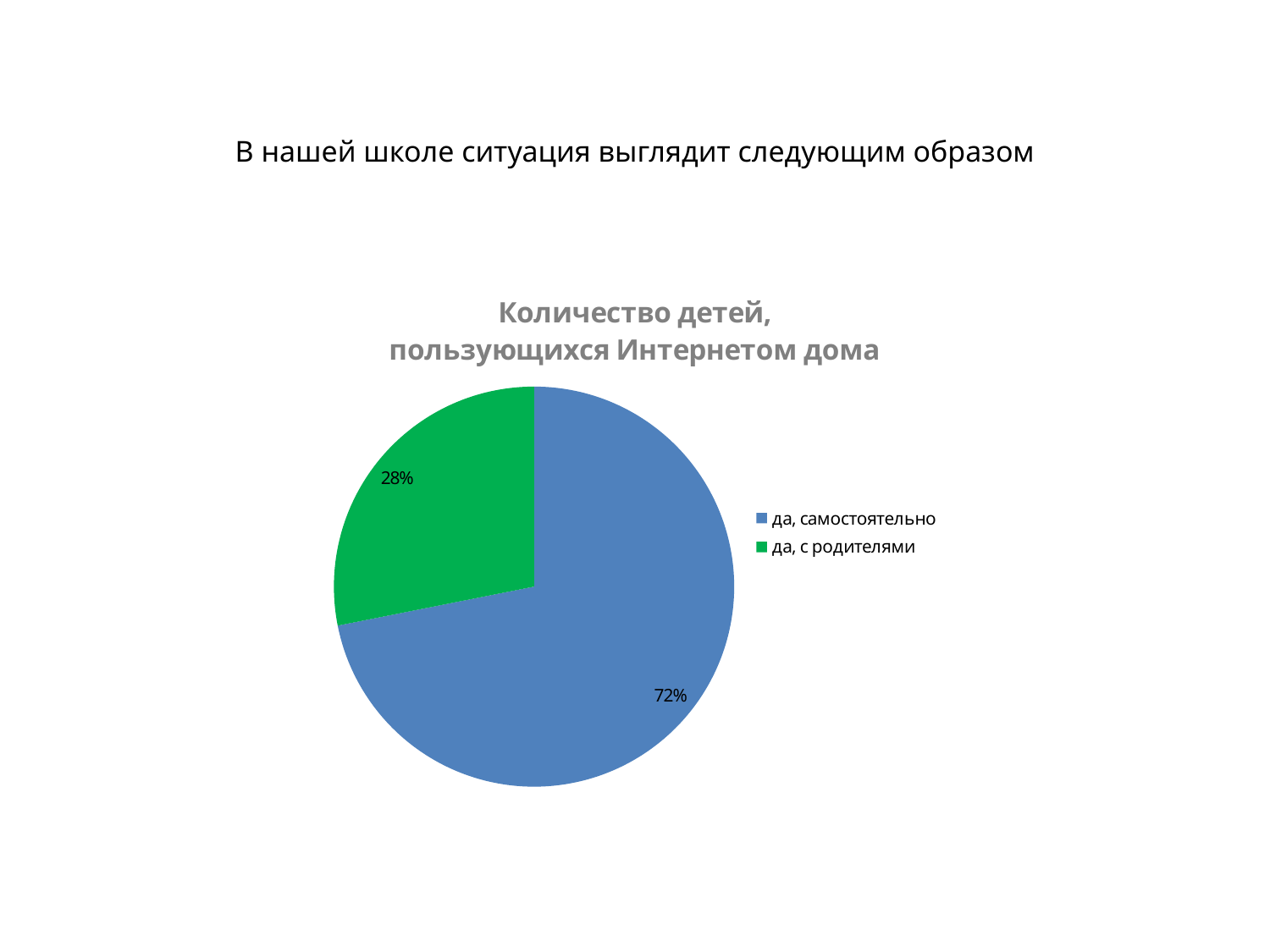
Which category has the largest slice of the pie? да, самостоятельно What is the total of the two slice percentages shown on the pie? 100% What colour is the slice for "да, с родителями"? green Which category has the smallest slice of the pie? да, с родителями What is the title of the chart? Количество детей, пользующихся Интернетом дома How many entries does the legend list? 2 What kind of chart is shown on the slide? pie chart What is the difference in percentage points between the "да, самостоятельно" slice and the "да, с родителями" slice? 44 Which slice is larger: "да, самостоятельно" or "да, с родителями"? да, самостоятельно How many categories does the pie chart have? 2 What share of the pie is labelled "да, с родителями"? 28% What share of the pie is labelled "да, самостоятельно"? 72%